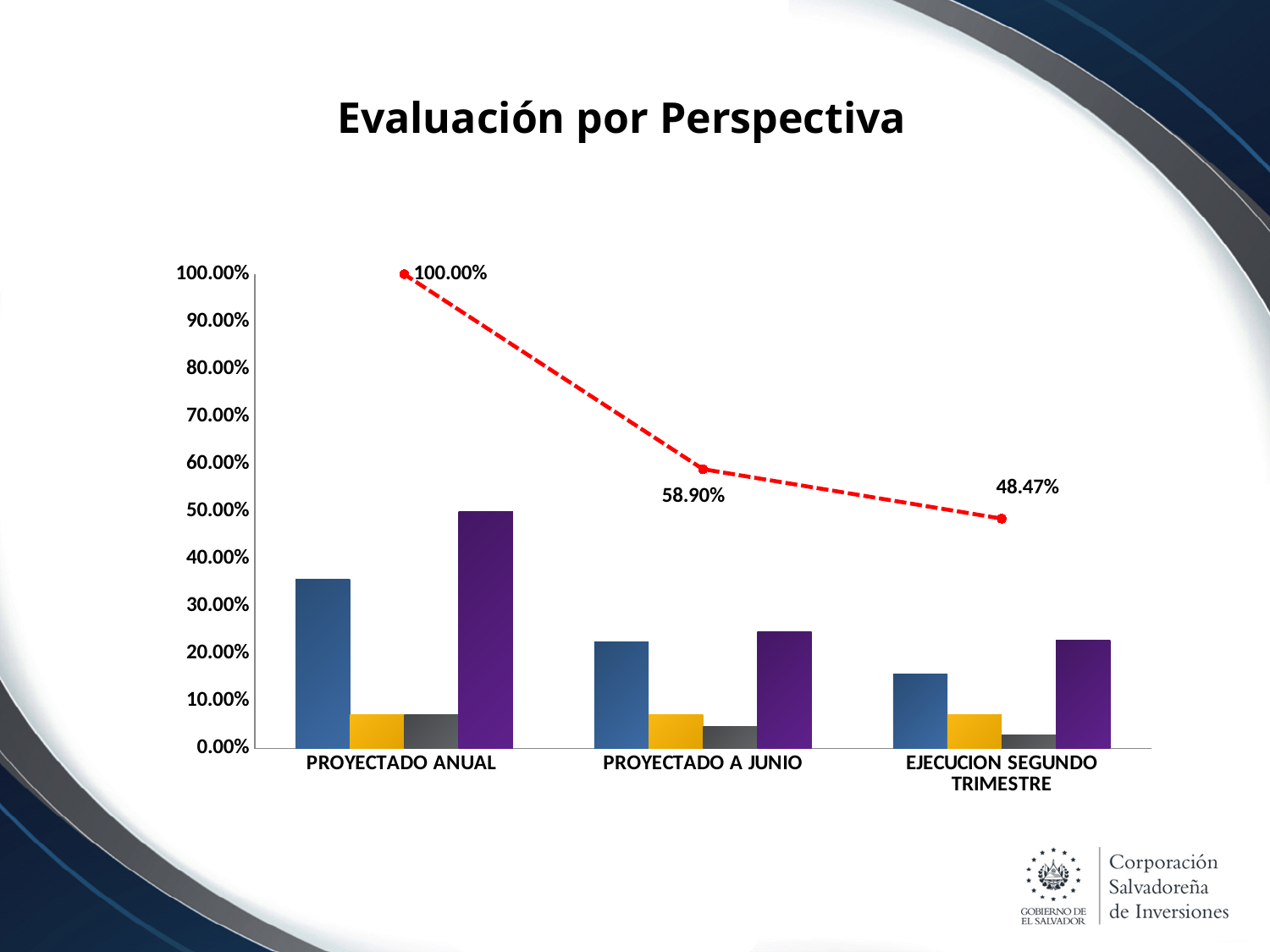
What is the difference between the dashed line values for PROYECTADO A JUNIO and EJECUCION SEGUNDO TRIMESTRE? 10.43% For which category is the dashed red line value highest? PROYECTADO ANUAL What value does the dashed red line show for EJECUCION SEGUNDO TRIMESTRE? 48.47% What is the title of the slide? Evaluación por Perspectiva What value does the dashed red line show for PROYECTADO ANUAL? 100.00% How many categories are shown on the x axis? 3 Do the dashed red line values rise or fall from left to right across the categories? fall What is the difference between the dashed line values for PROYECTADO ANUAL and PROYECTADO A JUNIO? 41.10% What kind of chart is shown on the slide? a combined bar and line chart What value does the dashed red line show for PROYECTADO A JUNIO? 58.90% For which category is the dashed red line value lowest? EJECUCION SEGUNDO TRIMESTRE Which has the larger dashed line value, PROYECTADO A JUNIO or EJECUCION SEGUNDO TRIMESTRE? PROYECTADO A JUNIO